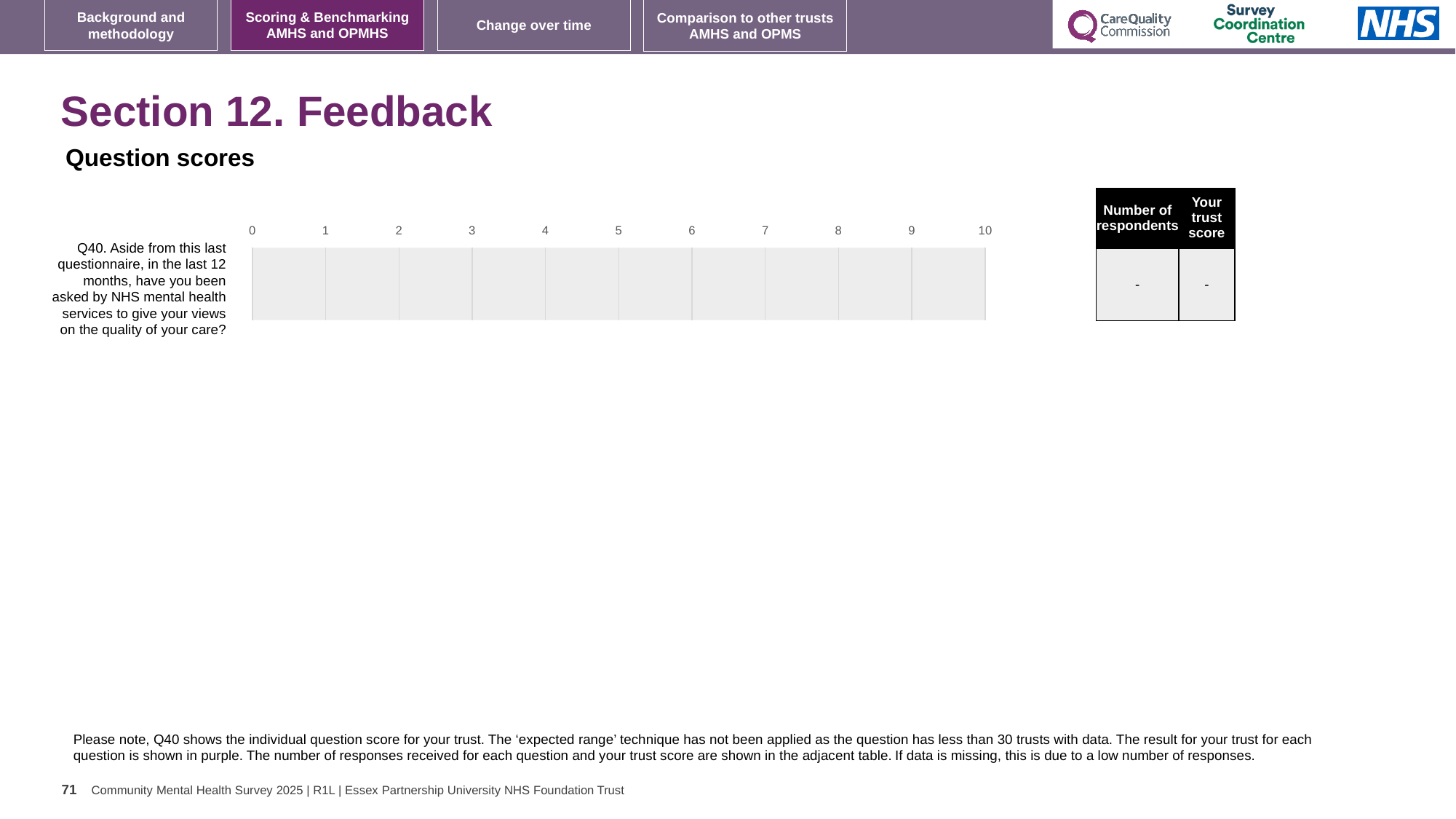
How many questions (categories) are shown on the Question scores chart? 1 What is shown in the 'Number of respondents' column of the table for Q40? - What type of chart is used for the Question scores on this slide? bar chart Which question number is plotted on the Question scores chart? Q40 What is shown in the 'Your trust score' column of the table for Q40? - What is the highest value shown on the horizontal axis of the Question scores chart? 10 What is the lowest value shown on the horizontal axis of the Question scores chart? 0